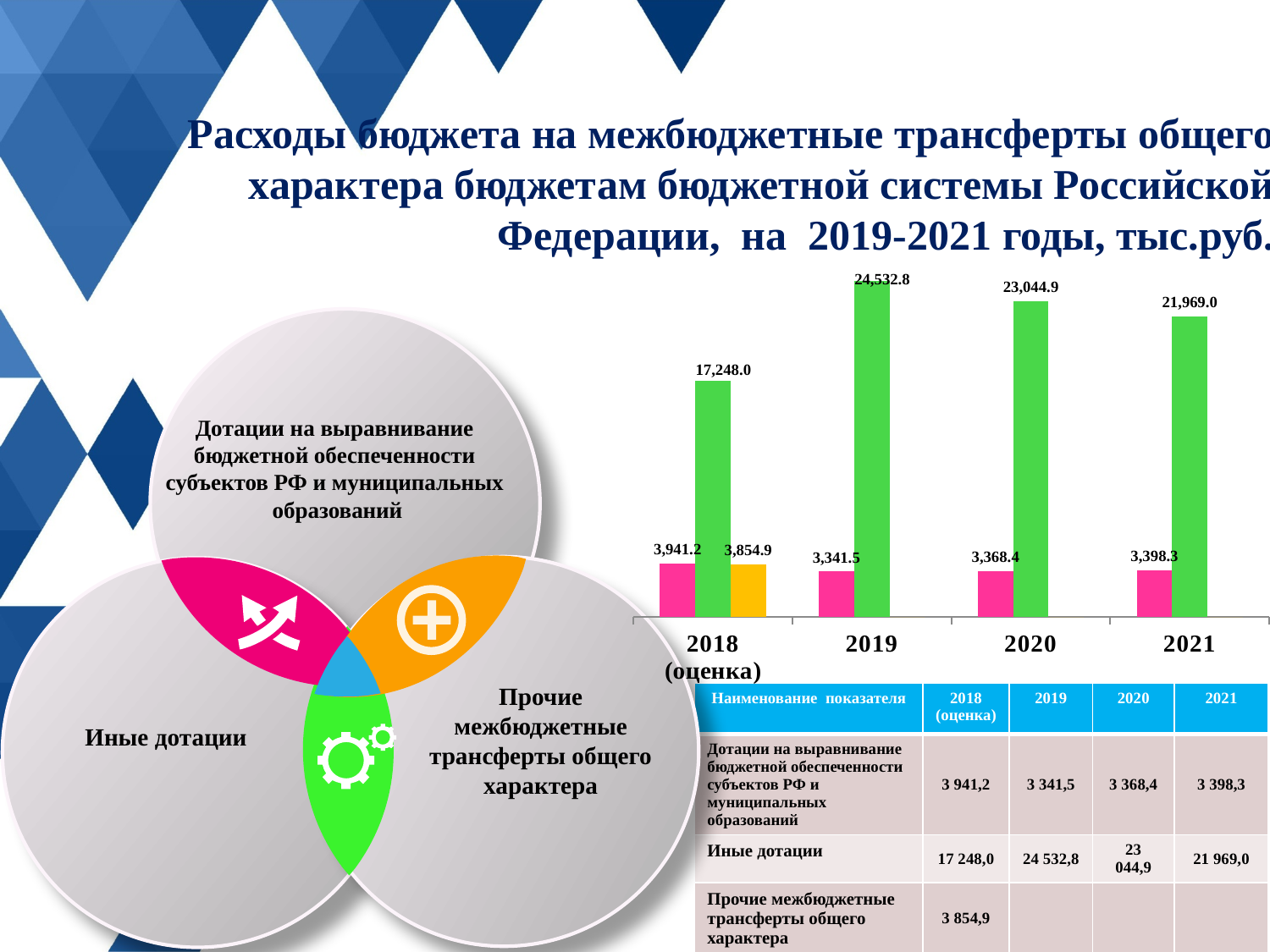
What is the value of the yellow bar for 2018 (оценка) in the bar chart? 3,854.9 What is the value of the green bar for 2018 (оценка) in the bar chart? 17,248.0 Which is larger in 2018 (оценка): the pink bar or the yellow bar? the pink bar (3,941.2) Which year is the only one with three bars in the bar chart? 2018 (оценка) In which year does the green bar reach its highest value? 2019 How many year categories are shown on the x axis of the bar chart? 4 What is the difference between the green bar values for 2019 and 2020? 1,487.9 What is the value of the tallest (green) bar for 2019 in the bar chart? 24,532.8 What is the value of the pink bar for 2021 in the bar chart? 3,398.3 What type of chart is shown on the slide? bar chart Does the green bar value rise or fall from 2019 to 2021? fall In which year is the pink bar the lowest? 2019